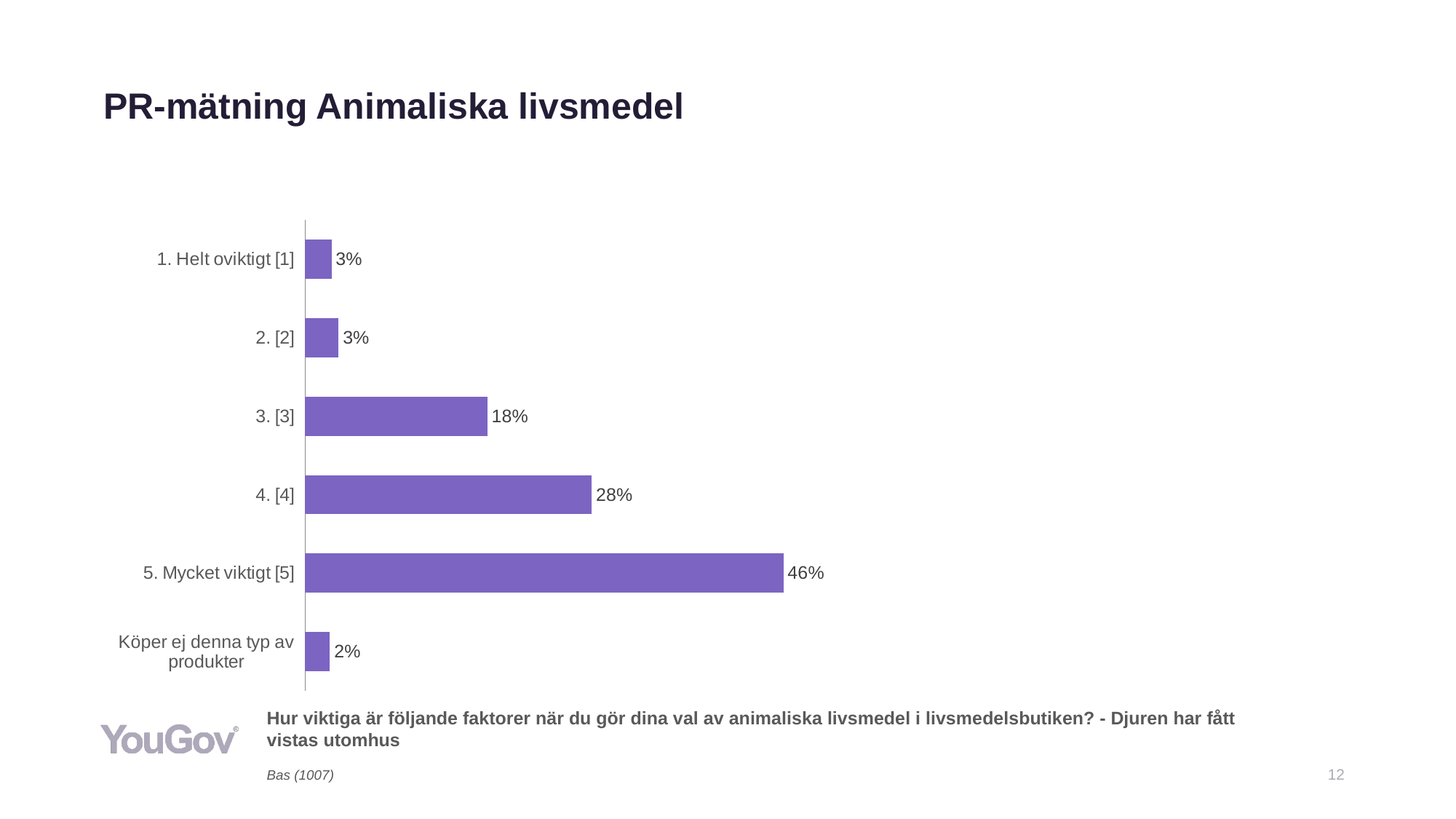
Which category has the lowest value? Köper ej denna typ av produkter How many categories are shown in the chart? 6 What is the value for "4. [4]"? 28% What is the value for "Köper ej denna typ av produkter"? 2% What is the base (Bas) stated below the chart? 1007 What is the value for "3. [3]"? 18% Which is larger, the value for "3. [3]" or the value for "4. [4]"? 4. [4] What kind of chart is shown on the slide? Bar chart What is the value for "5. Mycket viktigt [5]"? 46% What is the difference between the values for "5. Mycket viktigt [5]" and "4. [4]"? 18% What is the difference between the values for "4. [4]" and "3. [3]"? 10% Which category has the highest value? 5. Mycket viktigt [5]